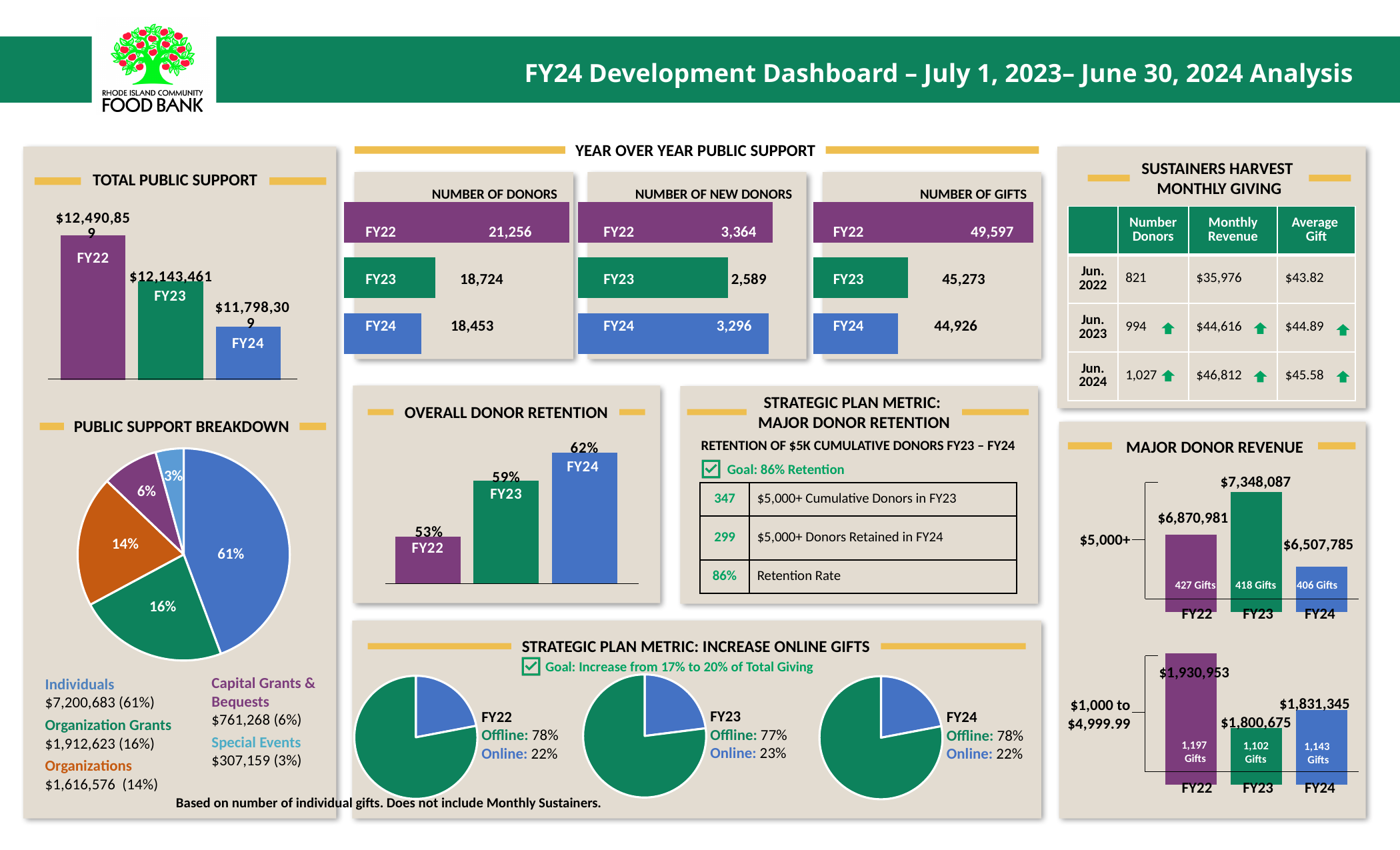
In the Total Public Support chart, what is the value for FY23? $12,143,461 In the Number of New Donors chart, which fiscal year has the lowest value? FY23 In the Major Donor Revenue chart, which fiscal year has the highest $5,000+ revenue? FY23 In the Public Support Breakdown pie chart, which category has the smallest slice? Special Events In the Number of Gifts chart, what is the difference between FY22 and FY23? 4,324 In the Public Support Breakdown pie chart, what share does Individuals have? 61% In the Strategic Plan Metric: Increase Online Gifts section, what is the Online share in the FY23 pie chart? 23% In the Overall Donor Retention chart, what is the value for FY22? 53% In the Number of Donors chart, what is the value for FY24? 18,453 In the Total Public Support chart, do the values rise or fall from FY22 to FY24? fall In the Major Donor Revenue chart, is the $1,000 to $4,999.99 revenue for FY22 larger or smaller than for FY24? larger In the Overall Donor Retention chart, how many bars are plotted? 3